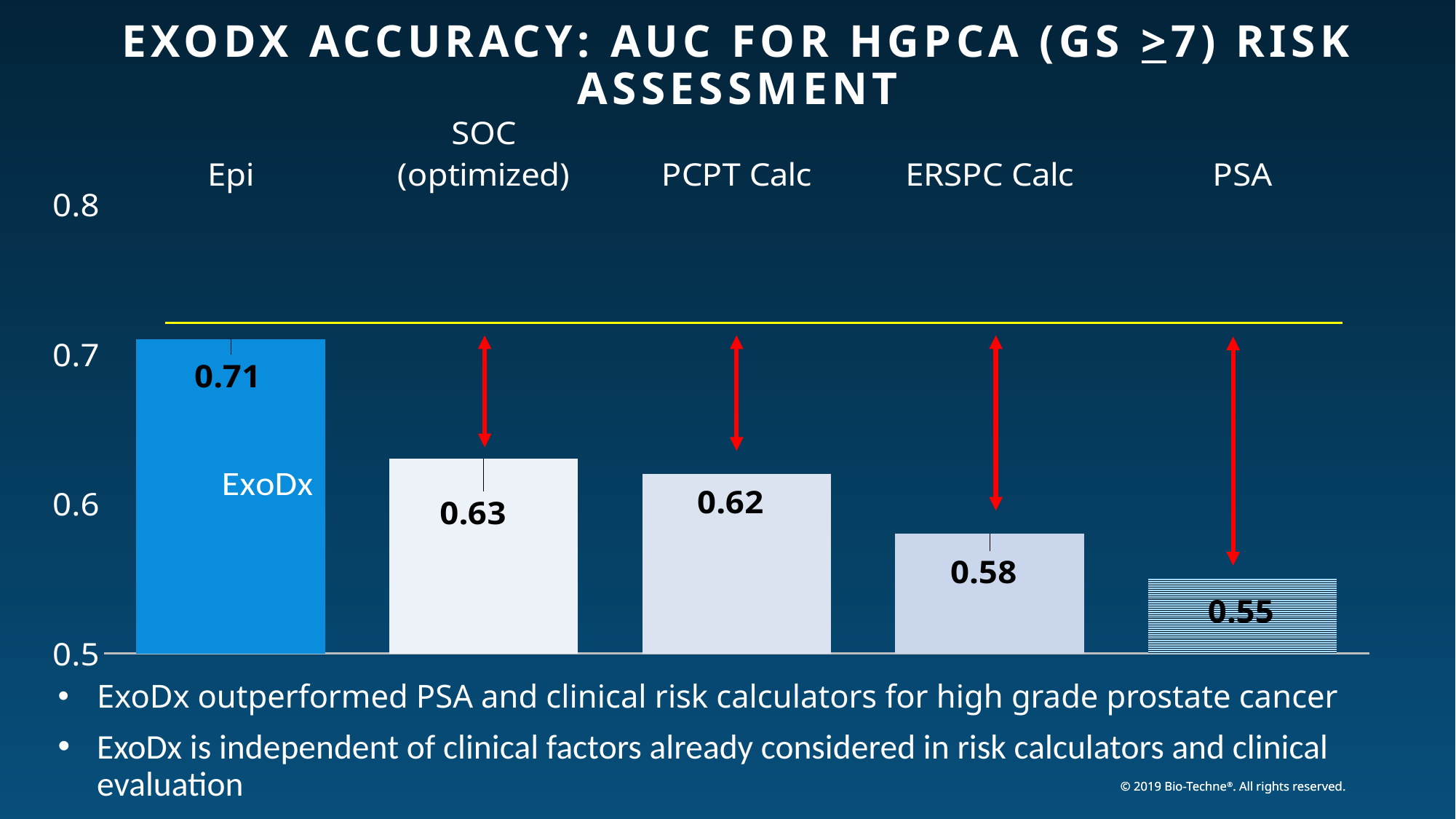
What kind of chart is shown on the slide? Bar chart Which category has the lowest AUC value? PSA What is the difference between the AUC for Epi and the AUC for PSA? 0.16 What is the AUC value shown for PCPT Calc? 0.62 Do the AUC values rise or fall from left to right across the categories? Fall What is the AUC value shown for SOC (optimized)? 0.63 Which category has the highest AUC value? Epi Which has a larger AUC, SOC (optimized) or ERSPC Calc? SOC (optimized) What is the AUC value shown for PSA? 0.55 What is the AUC value shown for ERSPC Calc? 0.58 How many categories are shown in the chart? 5 What is the AUC value shown for Epi (ExoDx)? 0.71